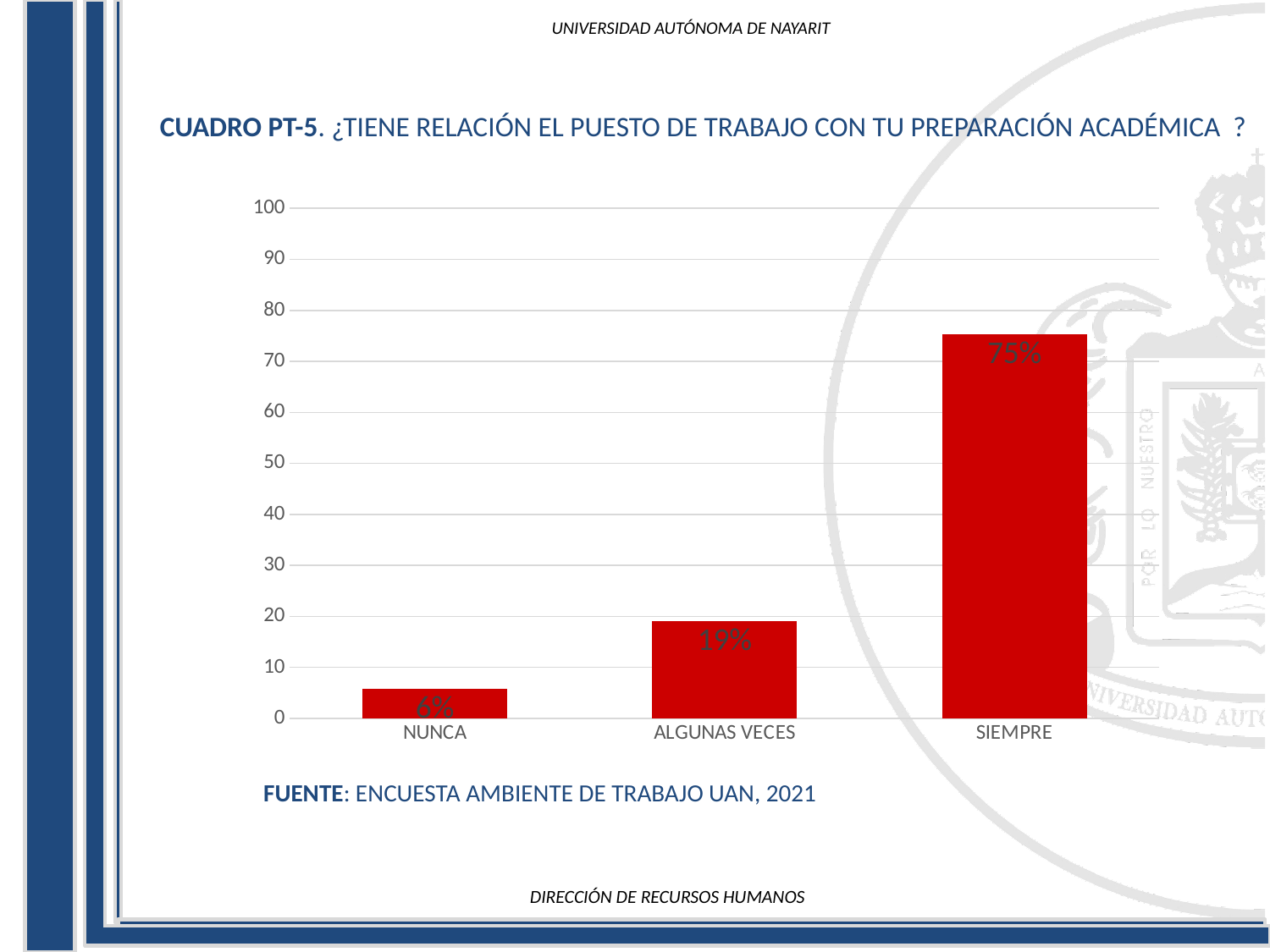
Which category has the highest value? SIEMPRE What is the difference between the values for SIEMPRE and ALGUNAS VECES? 56% Is the value for SIEMPRE greater or less than 70? greater How many categories are shown on the x axis? 3 What kind of chart is shown on the slide? bar chart Do the values rise or fall from left to right along the x axis? rise Which is larger, the value for ALGUNAS VECES or the value for NUNCA? ALGUNAS VECES What is the value for SIEMPRE? 75% What is the difference between the values for ALGUNAS VECES and NUNCA? 13% What is the value for ALGUNAS VECES? 19% Which category has the lowest value? NUNCA What is the value for NUNCA? 6%